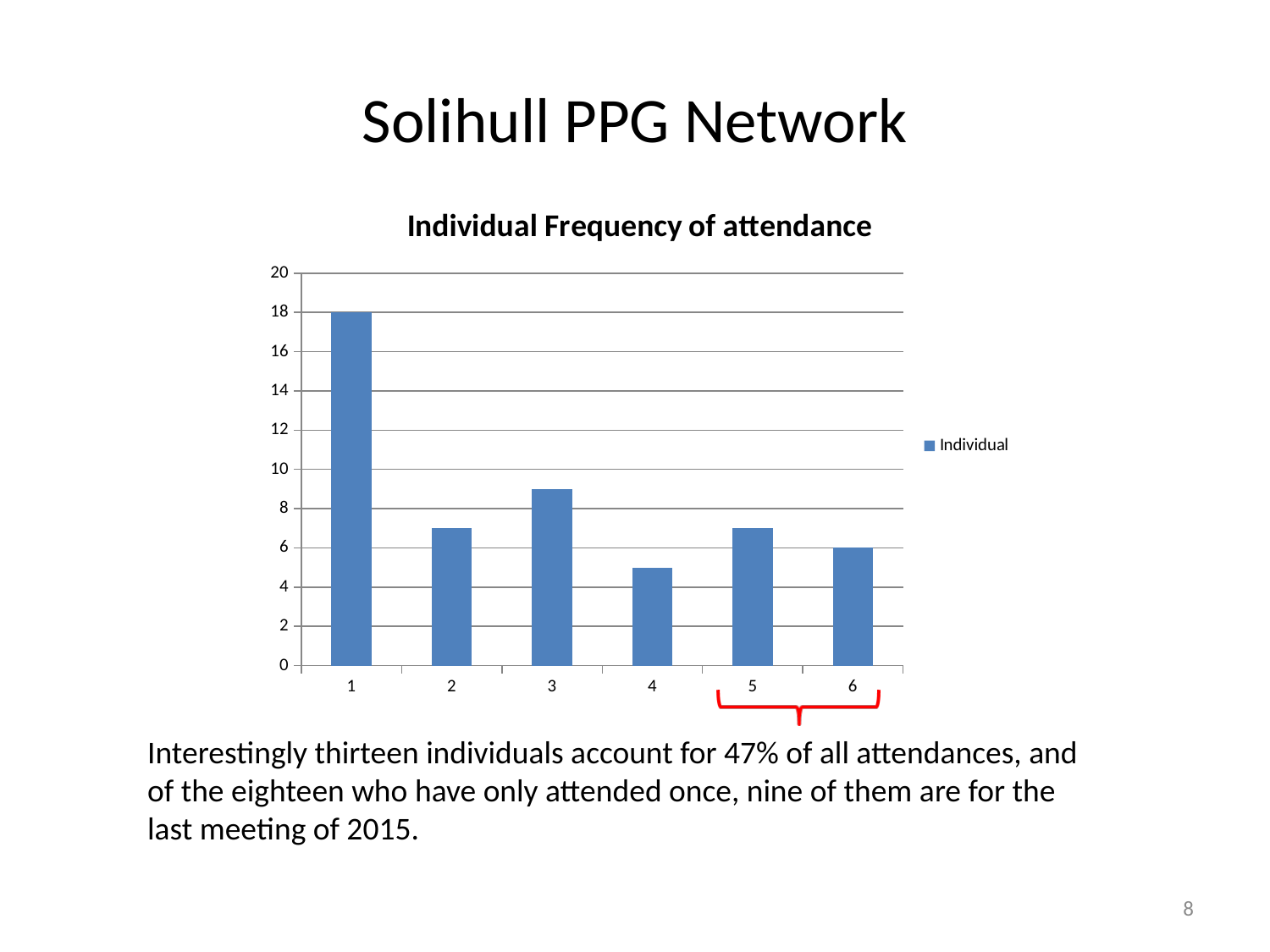
What is the value for category 1 in the Individual Frequency of attendance chart? 18 Is the value for category 3 greater or less than 8 in the Individual Frequency of attendance chart? greater What is the difference between the values for category 1 and category 6 in the Individual Frequency of attendance chart? 12 Is the value for category 2 greater or less than 10 in the Individual Frequency of attendance chart? less Which category has the lowest value in the Individual Frequency of attendance chart? 4 Which has a larger value in the Individual Frequency of attendance chart, category 3 or category 2? 3 Which category has the highest value in the Individual Frequency of attendance chart? 1 What kind of chart is the Individual Frequency of attendance chart? bar chart What is the value for category 6 in the Individual Frequency of attendance chart? 6 Is the value for category 4 greater or less than 6 in the Individual Frequency of attendance chart? less How many categories are shown on the x axis of the Individual Frequency of attendance chart? 6 How many series does the legend of the Individual Frequency of attendance chart list? 1